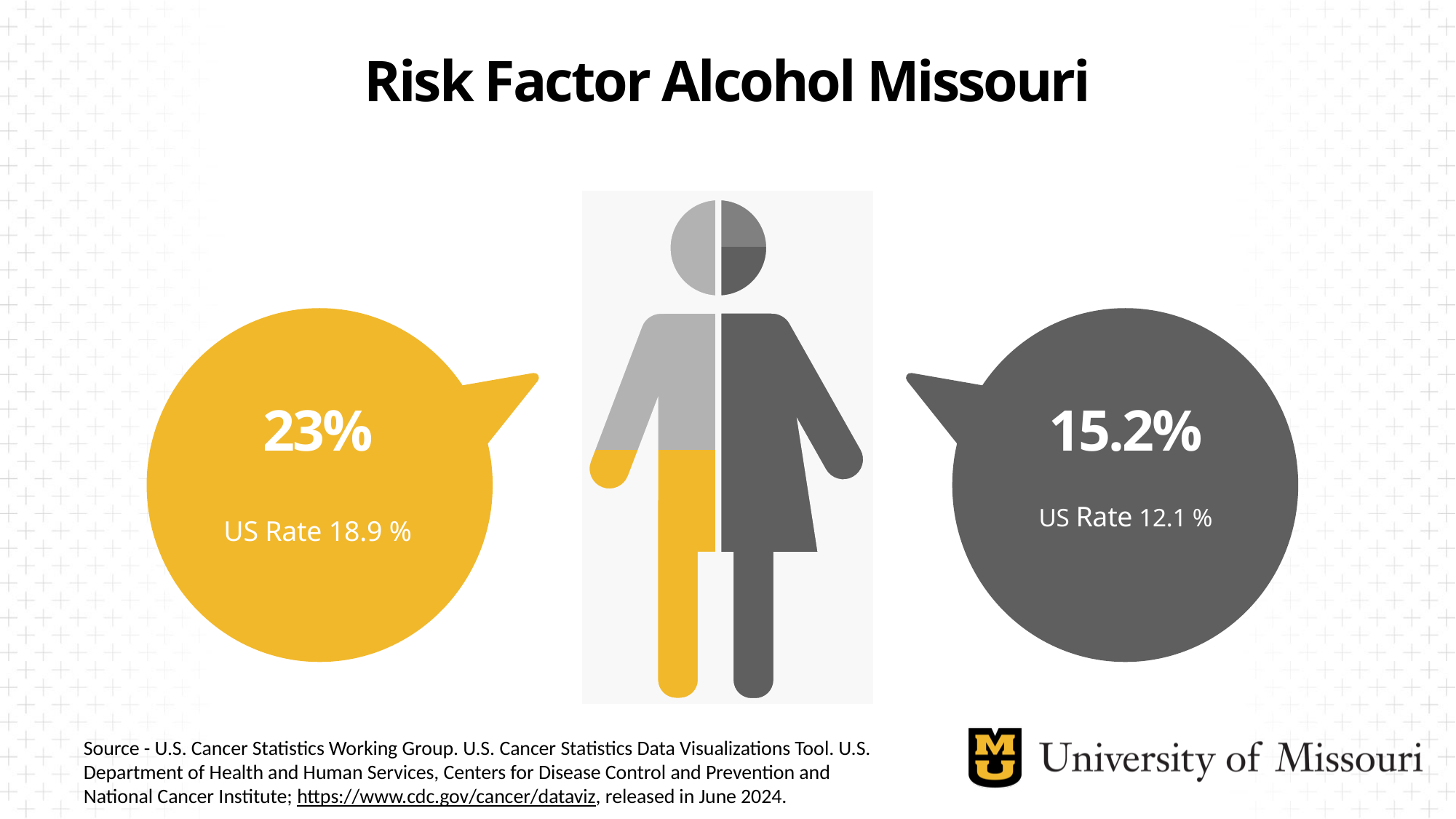
Which bubble shows the higher Missouri value, the yellow one on the left or the gray one on the right? The yellow one on the left (23%) What is the title of the slide? Risk Factor Alcohol Missouri How many speech-bubble values are shown on the slide? 2 What is the difference between the Missouri value and the US rate in the gray bubble? 3.1 percentage points What is the difference between the Missouri values in the yellow bubble and the gray bubble? 7.8 percentage points What is the difference between the Missouri value and the US rate in the yellow bubble? 4.1 percentage points What value is printed in the gray bubble on the right? 15.2% What value is printed in the yellow bubble on the left? 23% What US rate is shown in the yellow bubble on the left? 18.9 % Is the Missouri value in the gray bubble greater or less than its US rate? greater What US rate is shown in the gray bubble on the right? 12.1 % Is the Missouri value in the yellow bubble greater or less than its US rate? greater